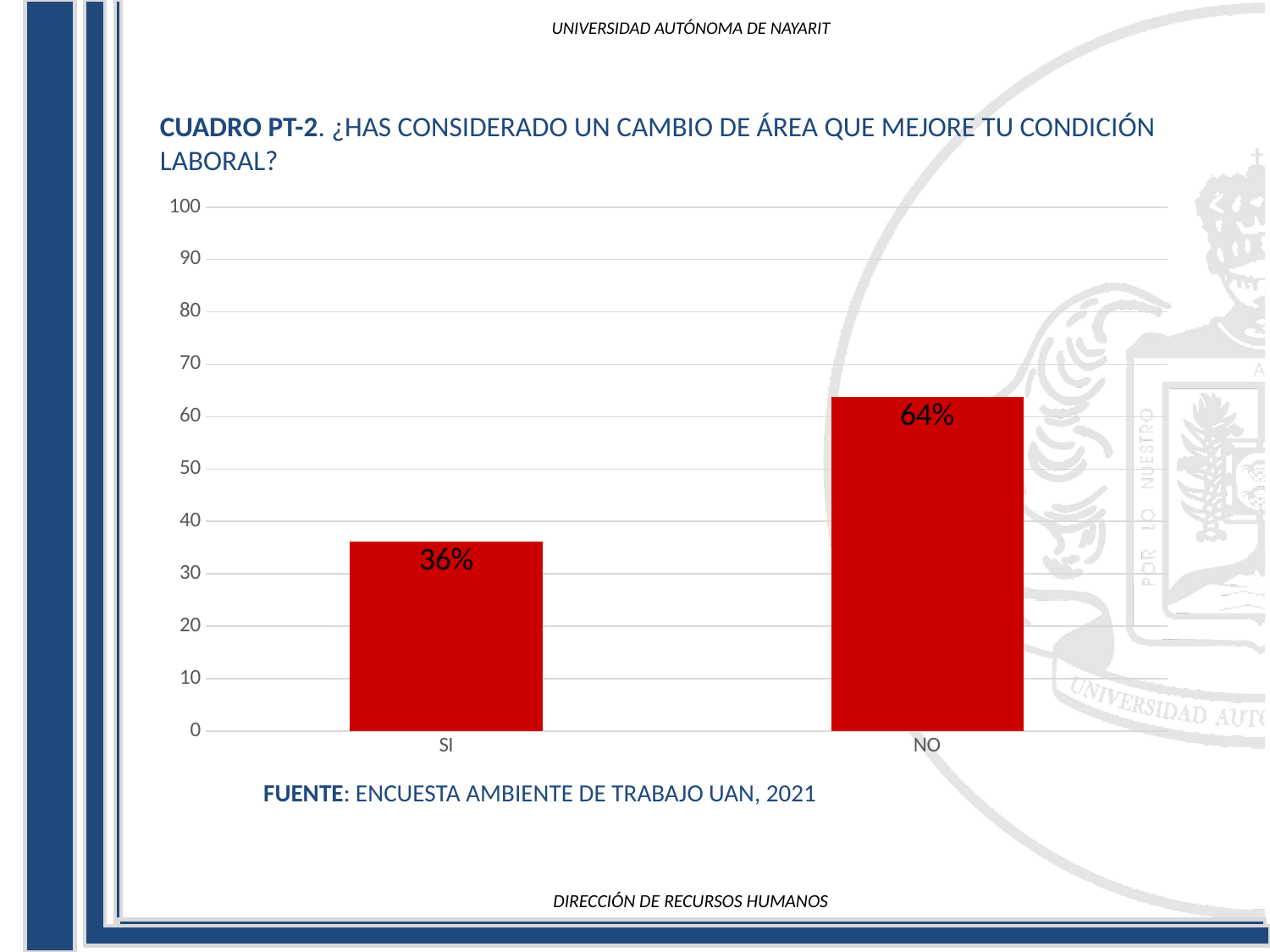
What is the value for SI? 36% What colour are the bars in the chart? red What kind of chart is shown on the slide? bar chart Which category has the highest value? NO Is the value for SI greater or less than 40? less How many categories are shown on the x axis? 2 Which category has the lowest value? SI Is the value for NO greater or less than 60? greater What is the difference between the values for NO and SI? 28% Which is larger, the value for SI or the value for NO? NO What is the source cited below the chart? ENCUESTA AMBIENTE DE TRABAJO UAN, 2021 What is the value for NO? 64%